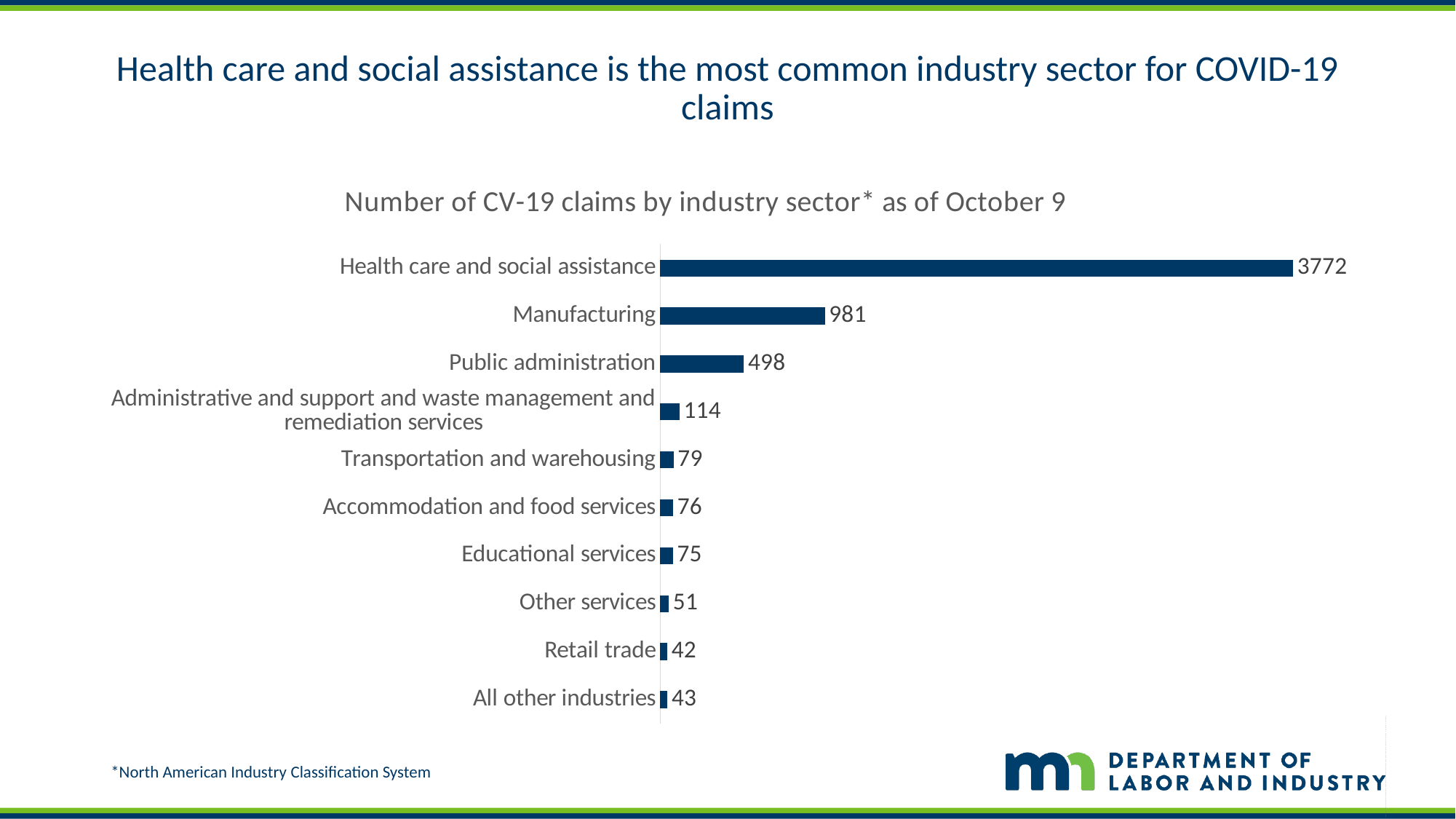
Which has more claims, Other services or All other industries? Other services What is the number of claims for Public administration? 498 How many claims are shown for Transportation and warehousing? 79 Which industry sector has the highest number of claims? Health care and social assistance How many industry sectors are shown in the chart? 10 What type of chart is used on this slide? Bar chart What is the difference in claims between Public administration and Administrative and support and waste management and remediation services? 384 What is the difference in claims between Health care and social assistance and Manufacturing? 2791 What is the title of the chart? Number of CV-19 claims by industry sector* as of October 9 How many CV-19 claims does the chart show for Manufacturing? 981 Which has more claims, Manufacturing or Public administration? Manufacturing Which industry sector has the lowest number of claims? Retail trade